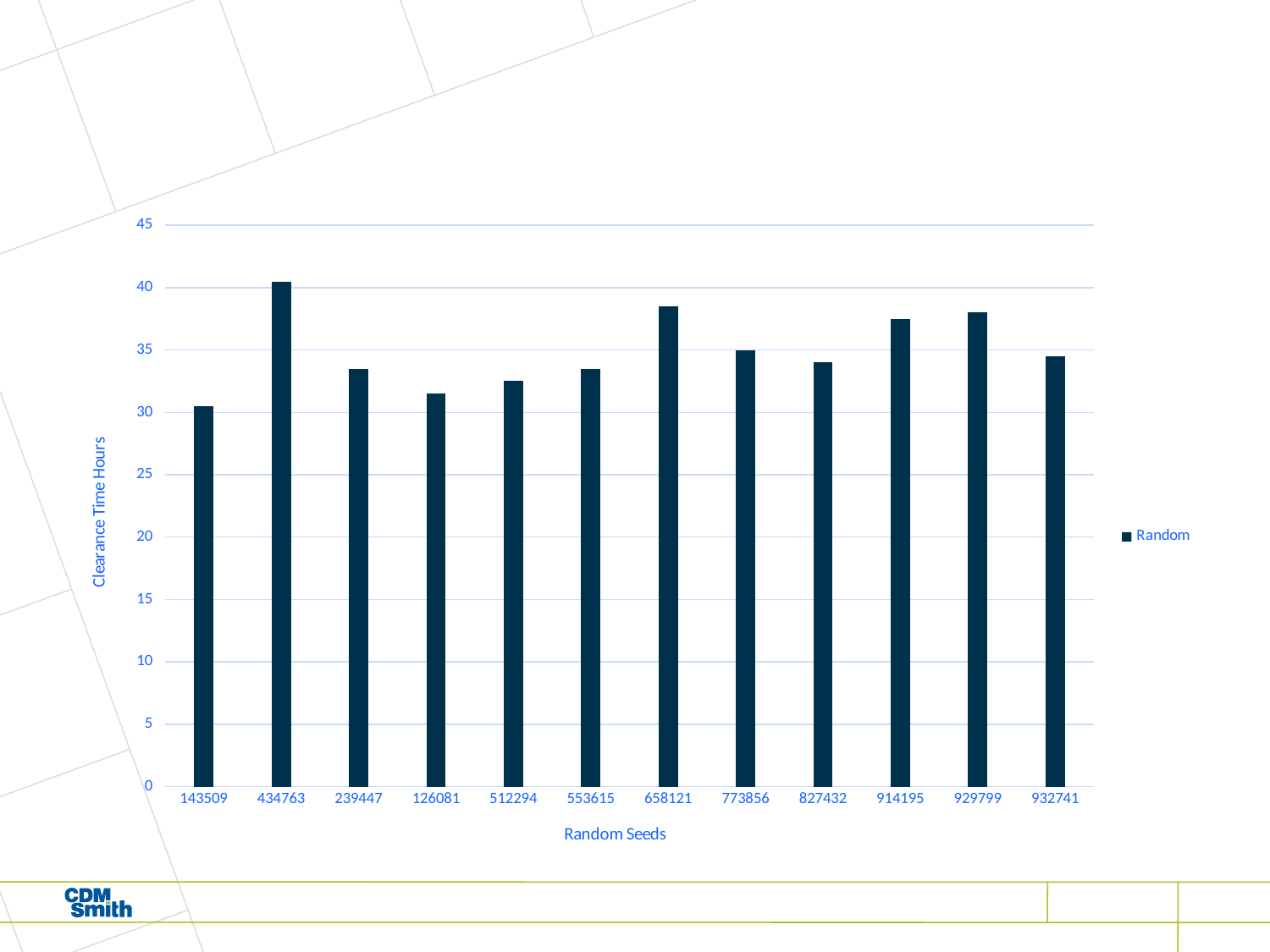
Is the value for seed 434763 greater or less than 40? greater Which has the larger clearance time, seed 434763 or seed 143509? 434763 How many series does the legend list? 1 Is the value for seed 143509 greater or less than 35? less What kind of chart is shown on the slide? bar chart Is the value for seed 658121 greater or less than 35? greater How many random seeds (categories) are plotted on the x axis? 12 Which random seed has the highest clearance time? 434763 Which has the larger clearance time, seed 658121 or seed 239447? 658121 What is the label of the y axis? Clearance Time Hours